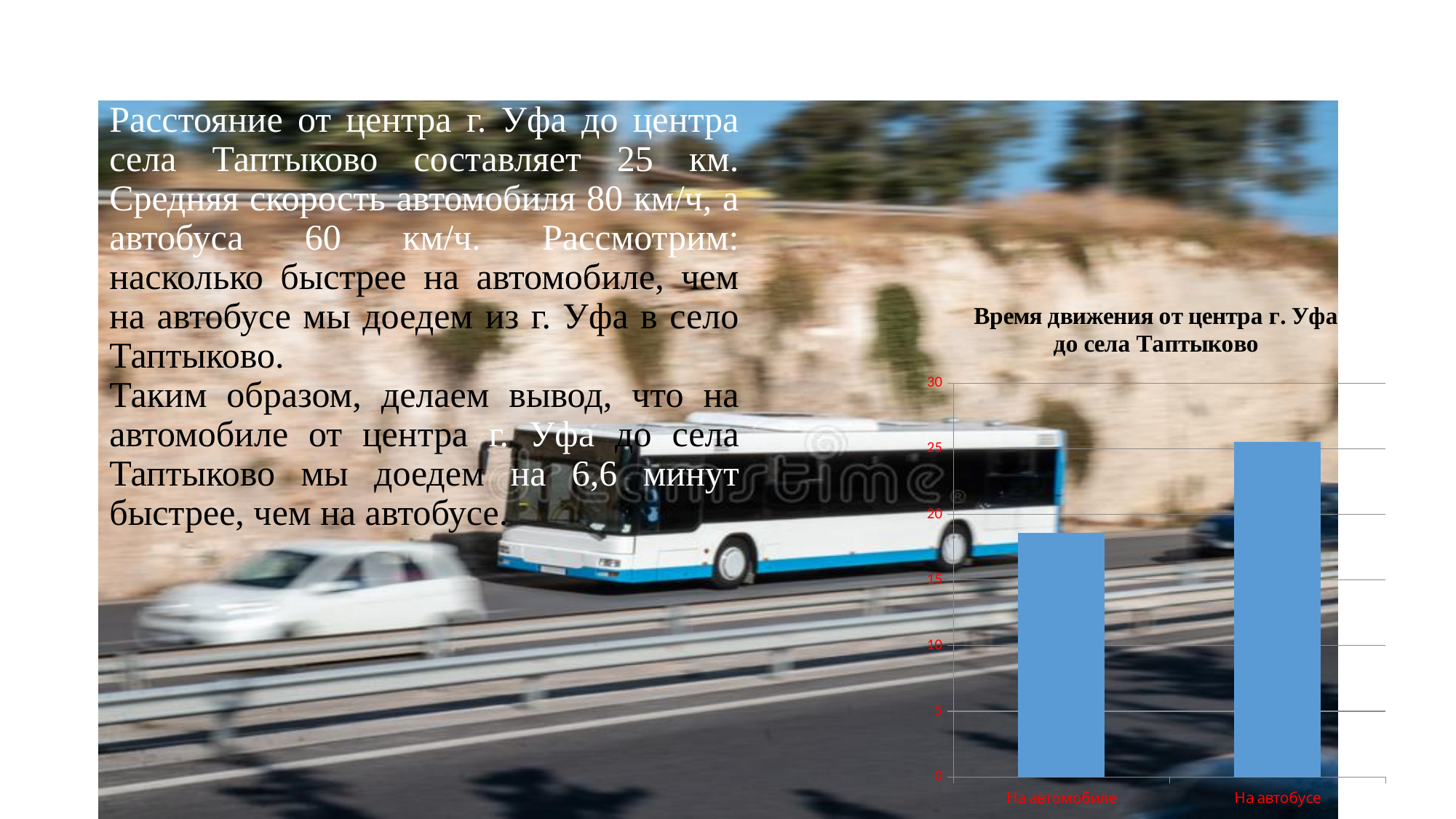
Do the values rise or fall from left to right along the x axis? rise Which category has the lowest value in the chart? На автомобиле Is the value for На автобусе greater or less than 30? less Is the value for На автомобиле greater or less than 15? greater What kind of chart is shown on the slide? bar chart Which is larger, the value for На автомобиле or the value for На автобусе? На автобусе What is the title of the chart? Время движения от центра г. Уфа до села Таптыково Is the value for На автомобиле greater or less than 20? less Which category has the highest value in the chart? На автобусе What is the highest value shown on the vertical axis of the chart? 30 How many categories are plotted in the chart? 2